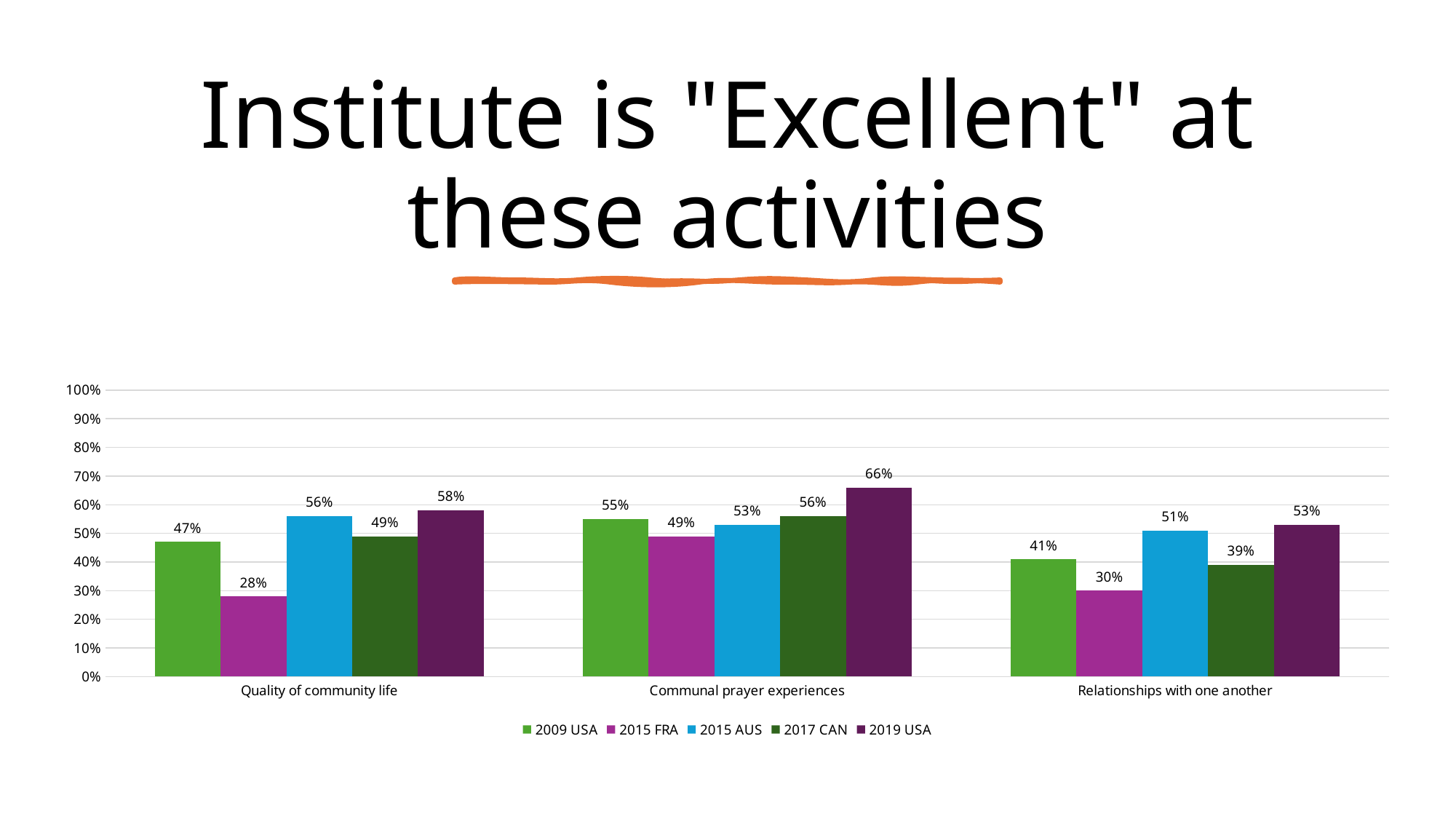
What kind of chart is shown on the slide? Bar chart Which series has the highest value in the Communal prayer experiences category? 2019 USA Which series is shown in light blue in the legend? 2015 AUS How many categories are shown on the x axis? 3 How many series does the legend list? 5 What is the value for 2017 CAN in the Relationships with one another category? 39% Which is larger in the Communal prayer experiences category: 2009 USA or 2015 AUS? 2009 USA What is the value for 2019 USA in the Communal prayer experiences category? 66% Which series has the lowest value in the Relationships with one another category? 2015 FRA Is the value for 2015 AUS in the Relationships with one another category greater or less than 40%? greater What is the difference between the 2019 USA and 2015 FRA values in the Quality of community life category? 30% What is the value for 2015 FRA in the Quality of community life category? 28%